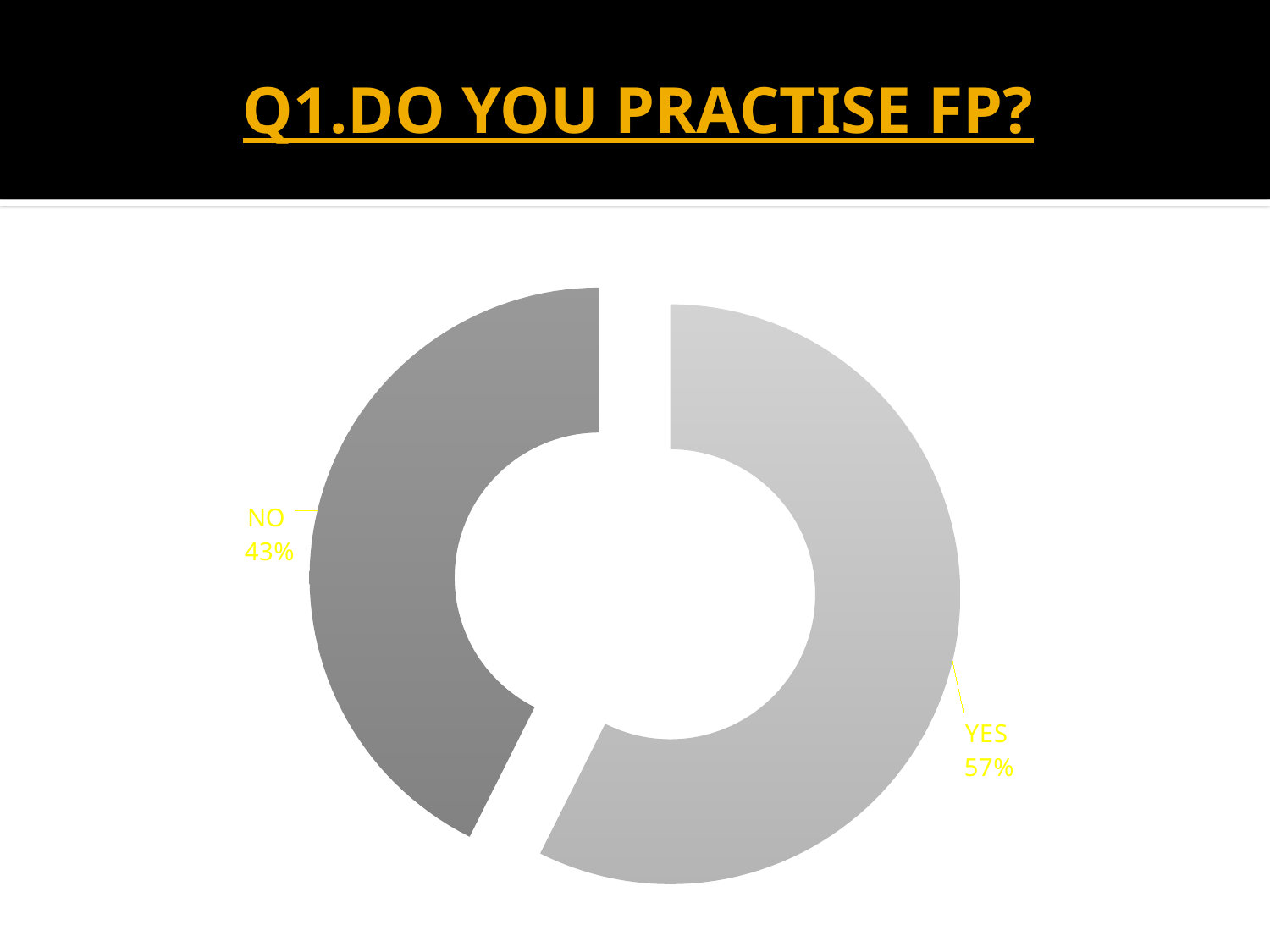
Which response has the larger share, YES or NO? YES What percentage of respondents answered NO? 43% Which slice is shown in the darker grey, YES or NO? NO What kind of chart is shown on the slide? Doughnut chart Which response has the smaller share? NO How many categories are shown in the chart? 2 What is the difference in percentage points between the YES and NO shares? 14 What is the share of the YES slice? 57% Is the share for YES larger than the share for NO? Yes What percentage of respondents answered YES? 57% What is the title of the slide? Q1.DO YOU PRACTISE FP?